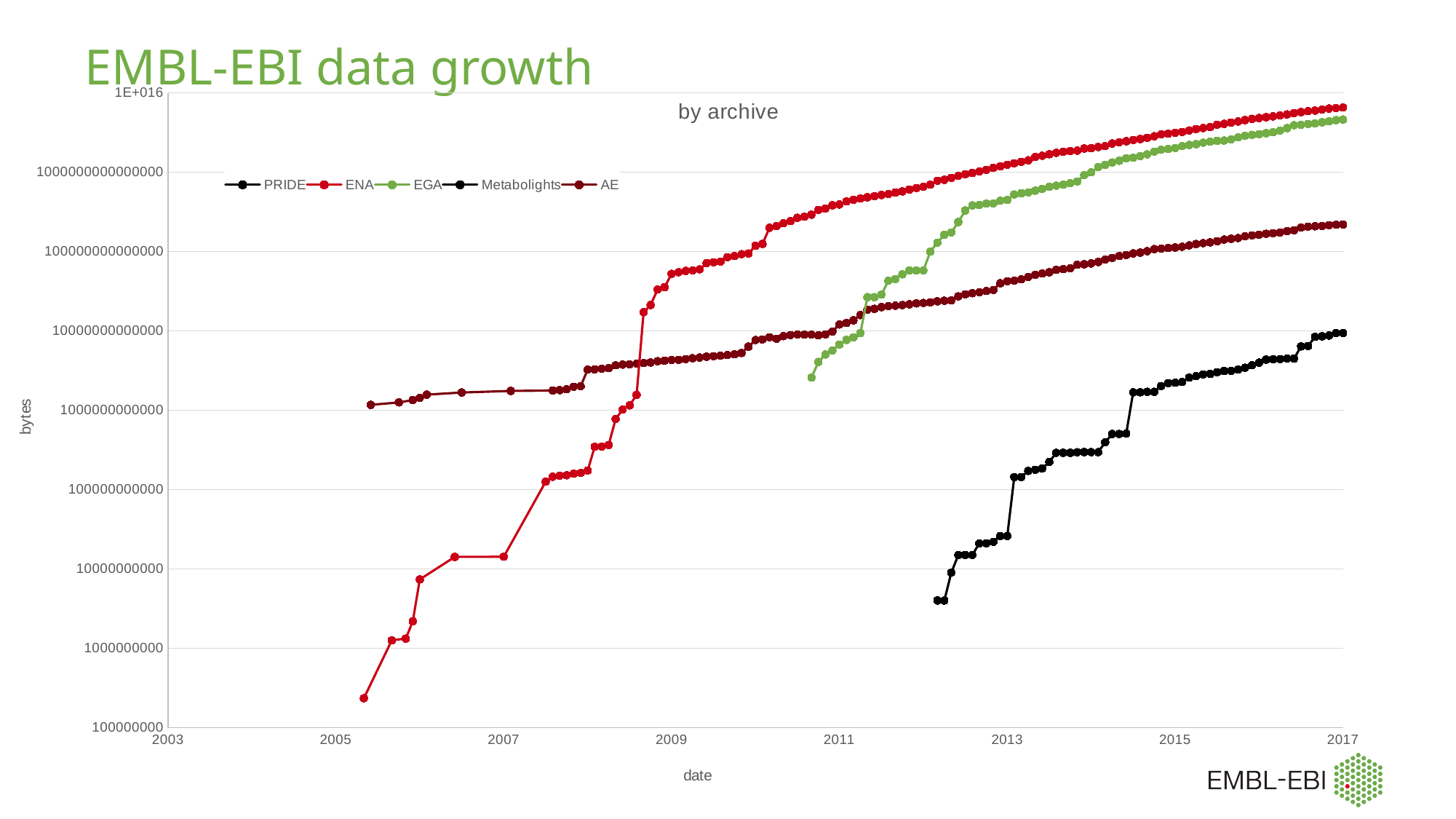
Which series has the highest value at the end of the chart in 2017? ENA In 2007, which series is larger, ENA or AE? AE What is the title of the chart? by archive Is the value for ENA in 2017 greater or less than 1000000000000000? greater Is the first plotted value for ENA (around 2005) greater or less than 1000000000? less How many series does the legend list? 5 Is the value for AE in 2017 greater or less than 100000000000000? greater What is the label of the y axis? bytes Does the ENA series rise or fall over time along the x axis? rise In 2017, which series is larger, EGA or AE? EGA What kind of chart is shown on the slide? line chart